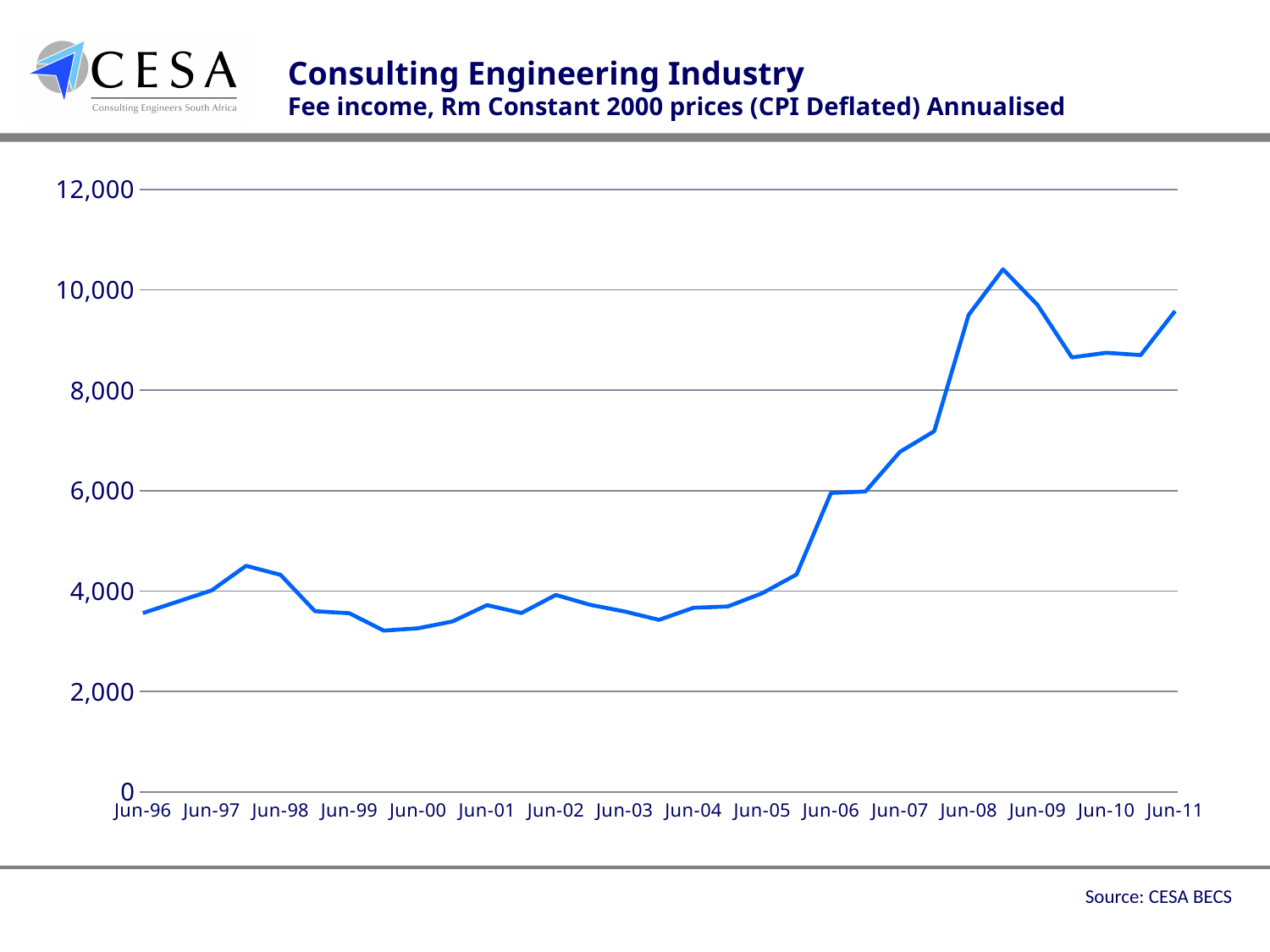
Is the fee income value for Jun-96 greater or less than 4,000? less Which has the higher fee income, Jun-96 or Jun-11? Jun-11 What is the highest value shown on the y axis? 12,000 What source is cited for the chart? CESA BECS Is the fee income value for Jun-07 greater or less than 6,000? greater What kind of chart is shown on the slide? line chart Which has the higher fee income, Jun-09 or Jun-10? Jun-09 Is the fee income value for Jun-08 greater or less than 8,000? greater How many date labels are shown on the x axis? 16 Overall, does fee income rise or fall from Jun-96 to Jun-11? rise